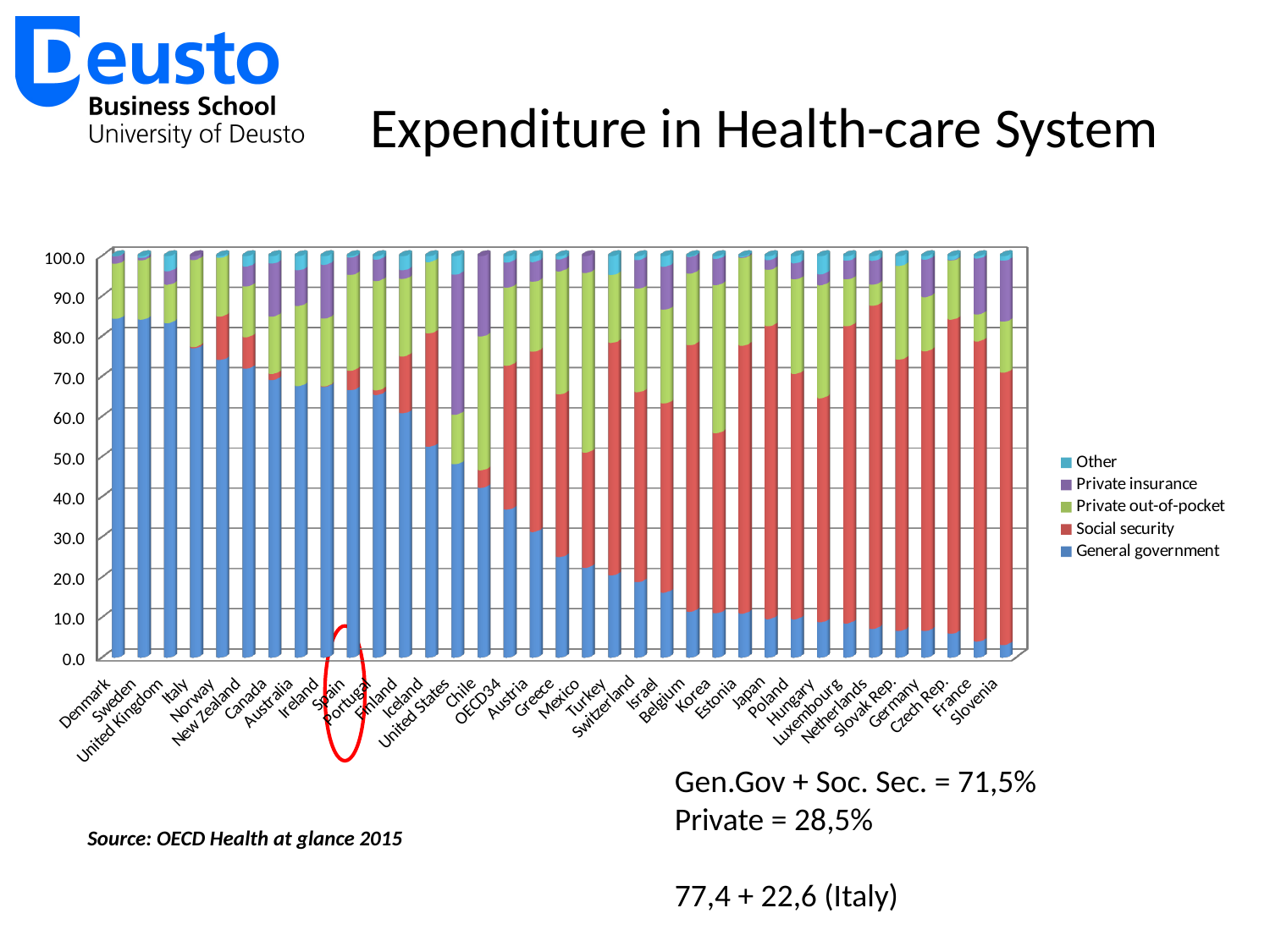
Is the General government value for Chile greater or less than 50? less Which has a larger General government value, Italy or Korea? Italy How many categories are plotted along the x axis? 35 What kind of chart is shown on the slide? Stacked bar chart Which country on the x axis is circled in red? Spain What is the title of the chart? Expenditure in Health-care System Is the General government value for Denmark greater or less than 80? greater Which has a larger General government value, Denmark or Slovenia? Denmark Does the General government share generally rise or fall moving from left to right along the x axis? fall Is the General government value for United States greater or less than 50? less How many series does the legend list? 5